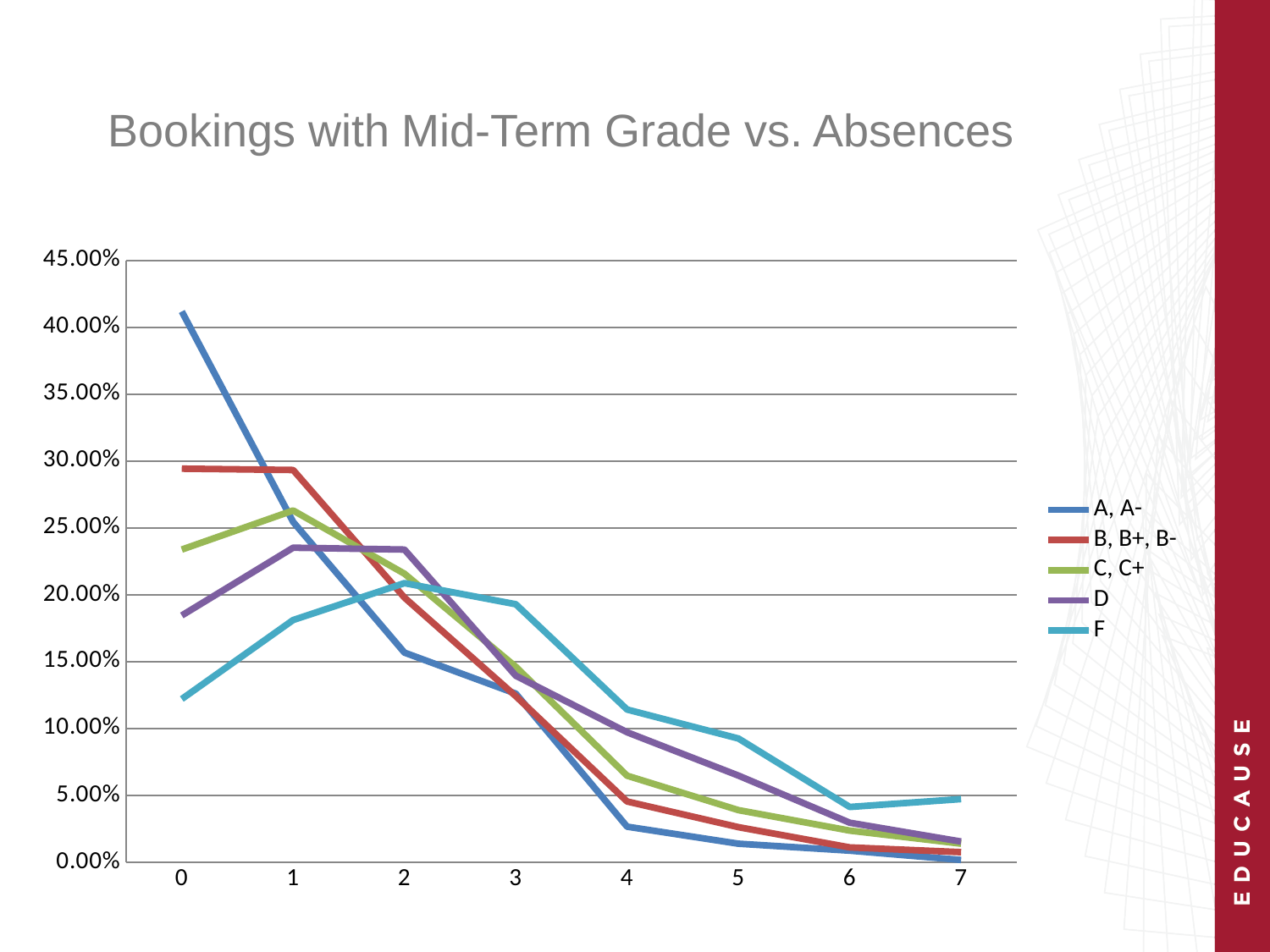
Which series has the highest value at 7 absences? F What kind of chart is shown on the slide? line chart At 4 absences, which is larger: the value for D or the value for A, A-? D How many series does the legend list? 5 Is the value for A, A- at 0 absences greater or less than 35.00%? greater Does the A, A- series rise or fall as absences increase from 0 to 7? fall Which series has the highest value at 0 absences? A, A- What is the title of the chart? Bookings with Mid-Term Grade vs. Absences How many points are on the x axis (absence values)? 8 Is the value for F at 0 absences greater or less than 15.00%? less Is the value for D at 1 absence greater or less than 20.00%? greater Which series has the lowest value at 0 absences? F